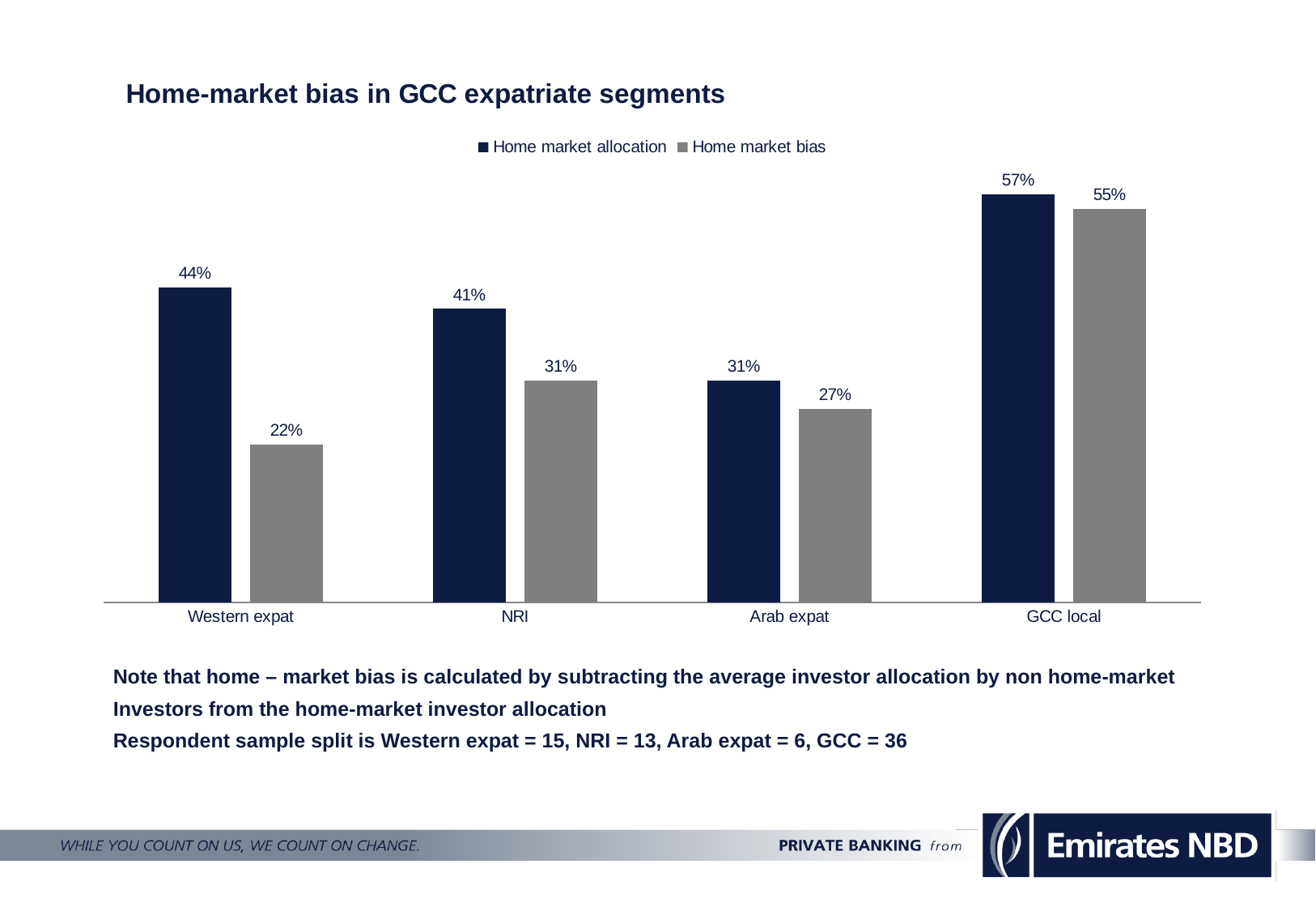
What is the Home market allocation value for Western expat? 44% What is the Home market bias value for NRI? 31% What is the title of the chart? Home-market bias in GCC expatriate segments How many series does the legend list? 2 What is the Home market bias value for GCC local? 55% What is the difference between Home market allocation and Home market bias for Western expat? 22% Which category has the highest Home market allocation? GCC local Which is larger for Arab expat: Home market allocation or Home market bias? Home market allocation What kind of chart is shown on the slide? Bar chart Which category has the lowest Home market bias? Western expat Which series is shown in dark navy bars? Home market allocation How many categories are shown on the x axis? 4